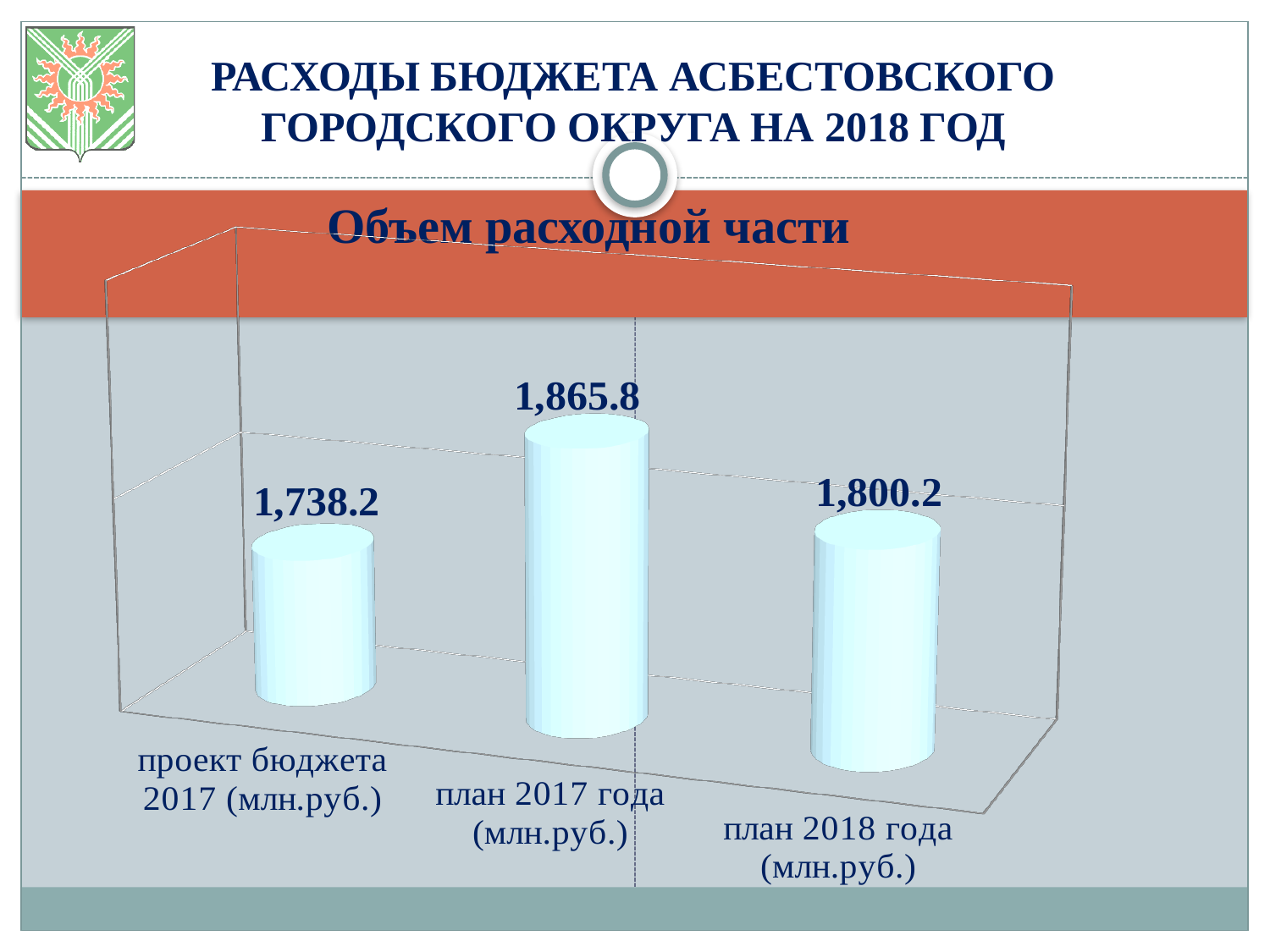
What is the value for "план 2017 года (млн.руб.)"? 1,865.8 What is the title of the chart? Объем расходной части What is the value for "проект бюджета 2017 (млн.руб.)"? 1,738.2 How many categories are shown in the chart? 3 Which is larger: the value for "план 2018 года" or for "проект бюджета 2017"? план 2018 года What is the difference between the values for "план 2017 года" and "план 2018 года"? 65.6 Which category has the highest value? план 2017 года (млн.руб.) What is the difference between the values for "план 2017 года" and "проект бюджета 2017"? 127.6 Which category has the lowest value? проект бюджета 2017 (млн.руб.) What is the difference between the values for "план 2018 года" and "проект бюджета 2017"? 62.0 What kind of chart is shown on the slide? bar chart What is the value for "план 2018 года (млн.руб.)"? 1,800.2